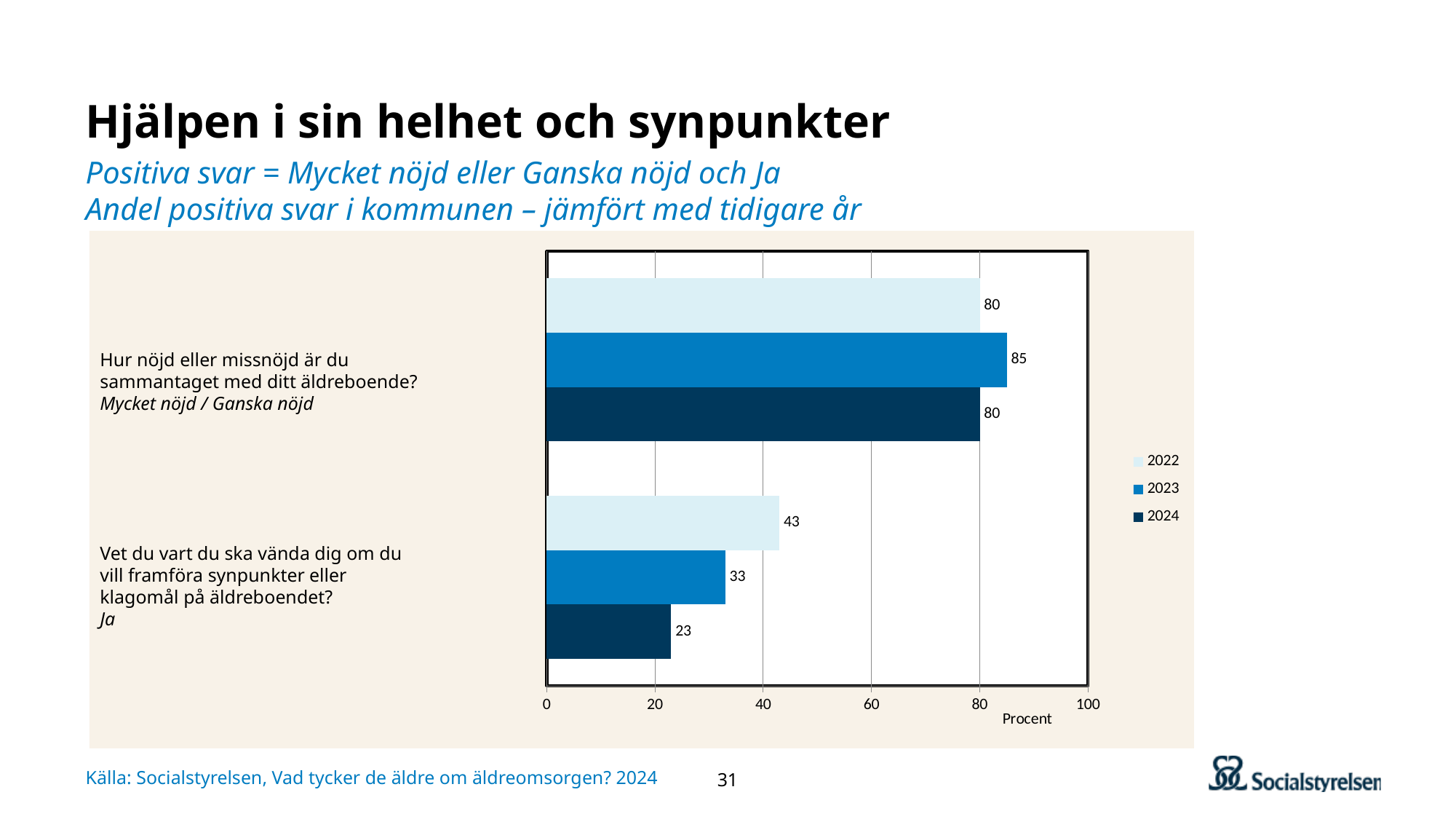
What is the 2023 value for the question 'Hur nöjd eller missnöjd är du sammantaget med ditt äldreboende?' 85 What is the 2022 value for the question 'Vet du vart du ska vända dig om du vill framföra synpunkter eller klagomål på äldreboendet?' 43 What is the difference between the 2023 and 2024 values for the question 'Hur nöjd eller missnöjd är du sammantaget med ditt äldreboende?' 5 What is the difference between the 2022 and 2024 values for the question 'Vet du vart du ska vända dig om du vill framföra synpunkter eller klagomål på äldreboendet?' 20 Which year has the lowest value for the question 'Vet du vart du ska vända dig om du vill framföra synpunkter eller klagomål på äldreboendet?' 2024 What kind of chart is shown on the slide? Bar chart Do the values for the question 'Vet du vart du ska vända dig om du vill framföra synpunkter eller klagomål på äldreboendet?' rise or fall from 2022 to 2024? Fall For 2024, which question has the larger value: 'Hur nöjd eller missnöjd är du sammantaget med ditt äldreboende?' or 'Vet du vart du ska vända dig om du vill framföra synpunkter eller klagomål på äldreboendet?' Hur nöjd eller missnöjd är du sammantaget med ditt äldreboende? What is the label of the horizontal axis of the chart? Procent Which year has the highest value for the question 'Hur nöjd eller missnöjd är du sammantaget med ditt äldreboende?' 2023 How many series does the legend list? 3 What is the 2024 value for the question 'Vet du vart du ska vända dig om du vill framföra synpunkter eller klagomål på äldreboendet?' 23